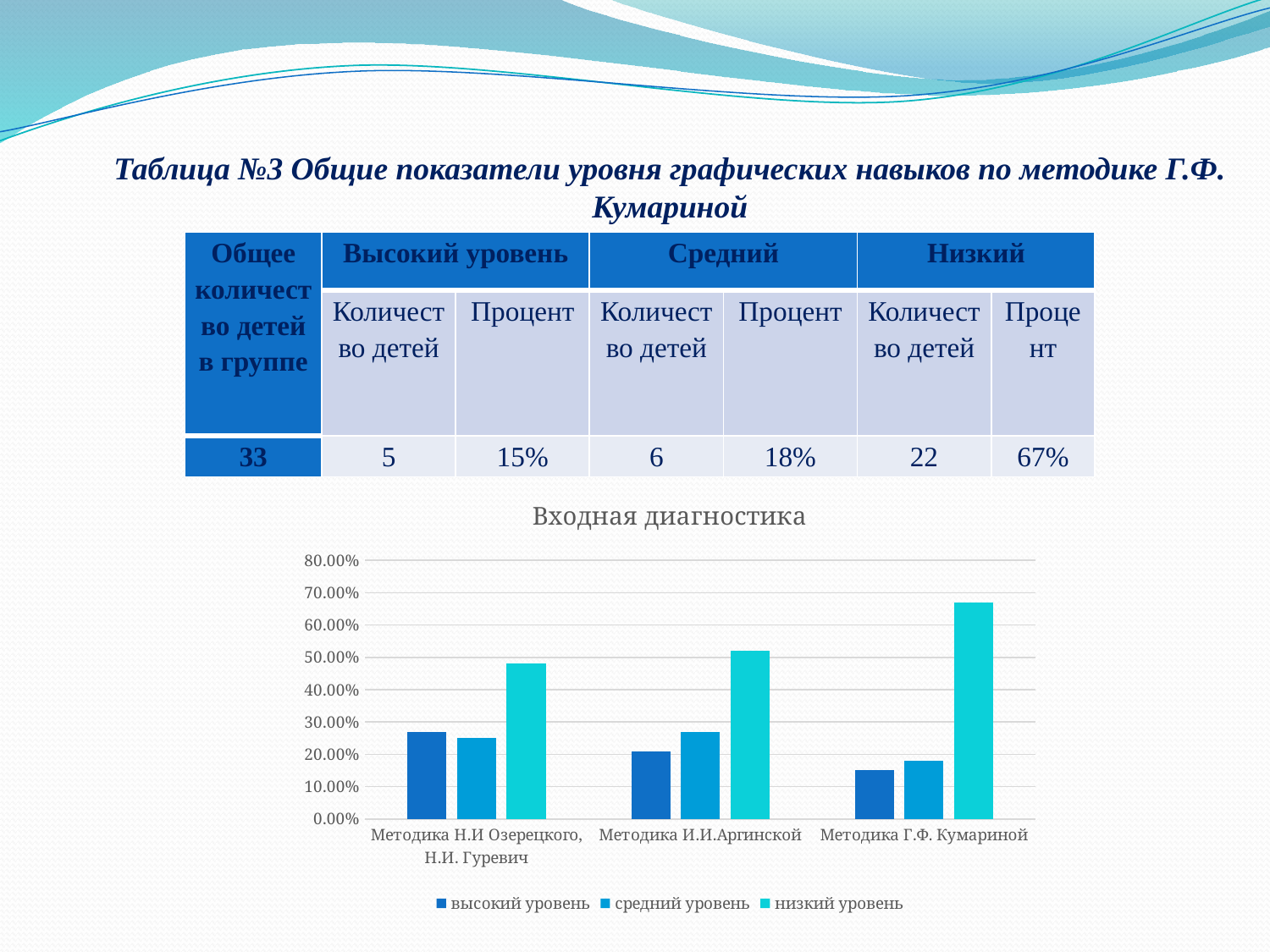
Does the 'низкий уровень' value rise or fall across the methods from left to right? rise What kind of chart is shown on the slide? bar chart For which method is the 'низкий уровень' bar the highest? Методика Г.Ф. Кумариной Is the 'низкий уровень' value for Методика Г.Ф. Кумариной greater or less than 60.00%? greater Is the 'низкий уровень' value for Методика Н.И Озерецкого, Н.И. Гуревич greater or less than 40.00%? greater Is the 'высокий уровень' value for Методика И.И.Аргинской greater or less than 30.00%? less Which series in the legend is shown in the lightest (cyan) colour? низкий уровень For Методика И.И.Аргинской, which is larger: the 'высокий уровень' bar or the 'низкий уровень' bar? низкий уровень How many series does the legend of the chart list? 3 How many methods (categories) are shown on the x axis of the chart? 3 For which method is the 'высокий уровень' bar the lowest? Методика Г.Ф. Кумариной What is the title of the chart? Входная диагностика